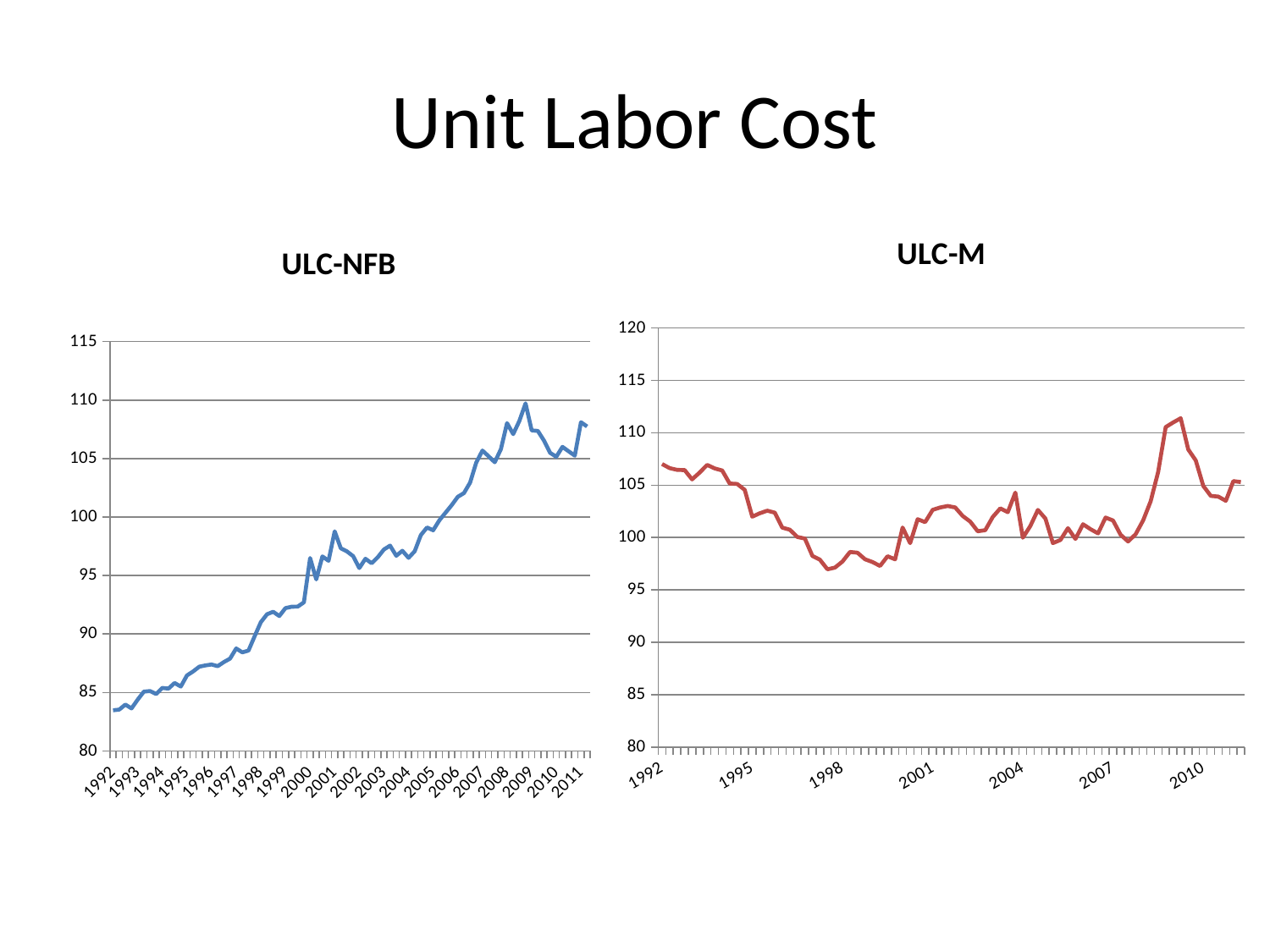
In the ULC-M chart, is the lowest value around 1998 greater or less than 100? less In the ULC-M chart, do the values fall or rise between 1992 and 1998? fall In the ULC-M chart, is the value at the start of 1992 greater or less than 105? greater In the ULC-NFB chart, do the values generally rise or fall from 1992 to 2011? rise What is the title of the chart on the right? ULC-M In the ULC-NFB chart, is the peak value around 2009 greater or less than 105? greater What kind of chart is the ULC-NFB chart on the left? line chart What colour is the line in the ULC-NFB chart? blue What kind of chart is the ULC-M chart on the right? line chart